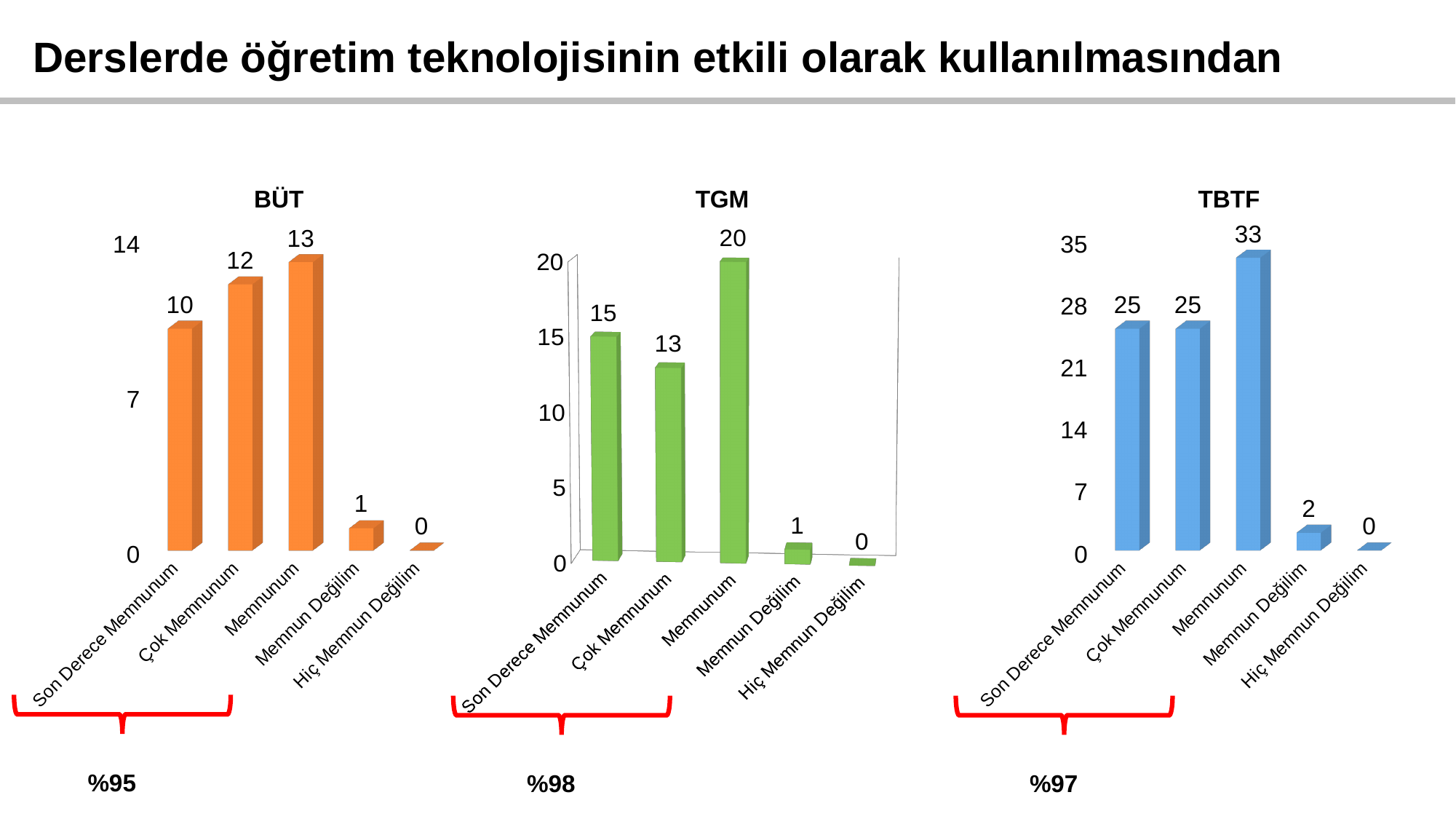
In the TGM chart, which is larger, the value for Son Derece Memnunum or the value for Çok Memnunum? Son Derece Memnunum What kind of chart is the TGM chart? bar chart In the TGM chart, which category has the lowest value? Hiç Memnun Değilim How many charts are on the slide? 3 In the BÜT chart, what is the difference between the values for Memnunum and Son Derece Memnunum? 3 How many categories does the BÜT chart show? 5 What percentage is shown below the TGM chart? %98 In the TGM chart, what is the value for Son Derece Memnunum? 15 In the TBTF chart, what is the value for Memnun Değilim? 2 In the TBTF chart, which category has the highest value? Memnunum In the BÜT chart, what is the value for Memnunum? 13 In the TBTF chart, what is the difference between the values for Memnunum and Çok Memnunum? 8